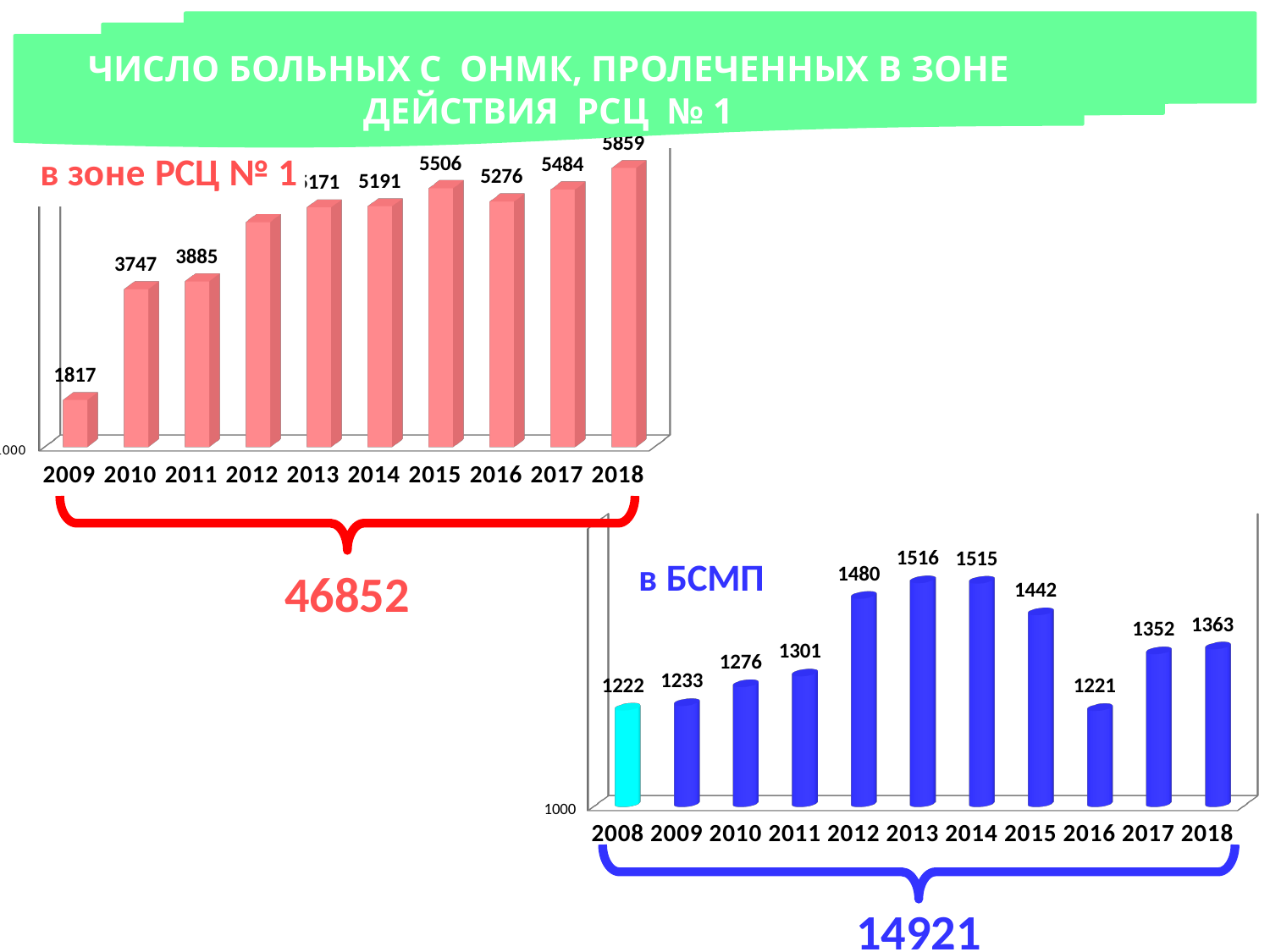
In the chart titled 'в БСМП', how many years are shown on the x axis? 11 In the chart titled 'в зоне РСЦ № 1', which year has the lowest value? 2009 In the chart titled 'в БСМП', what is the difference between the values for 2018 and 2017? 11 What kind of chart is the chart titled 'в БСМП'? Bar chart In the chart titled 'в БСМП', which bar is a different colour from the others? 2008 In the chart titled 'в БСМП', what is the value for 2012? 1480 In the chart titled 'в зоне РСЦ № 1', what is the value for 2009? 1817 In the chart titled 'в зоне РСЦ № 1', which is larger, the value for 2015 or the value for 2016? 2015 In the chart titled 'в зоне РСЦ № 1', which year has the highest value? 2018 In the chart titled 'в БСМП', what is the value for 2016? 1221 In the chart titled 'в зоне РСЦ № 1', what is the difference between the values for 2011 and 2010? 138 In the chart titled 'в зоне РСЦ № 1', what is the value for 2018? 5859